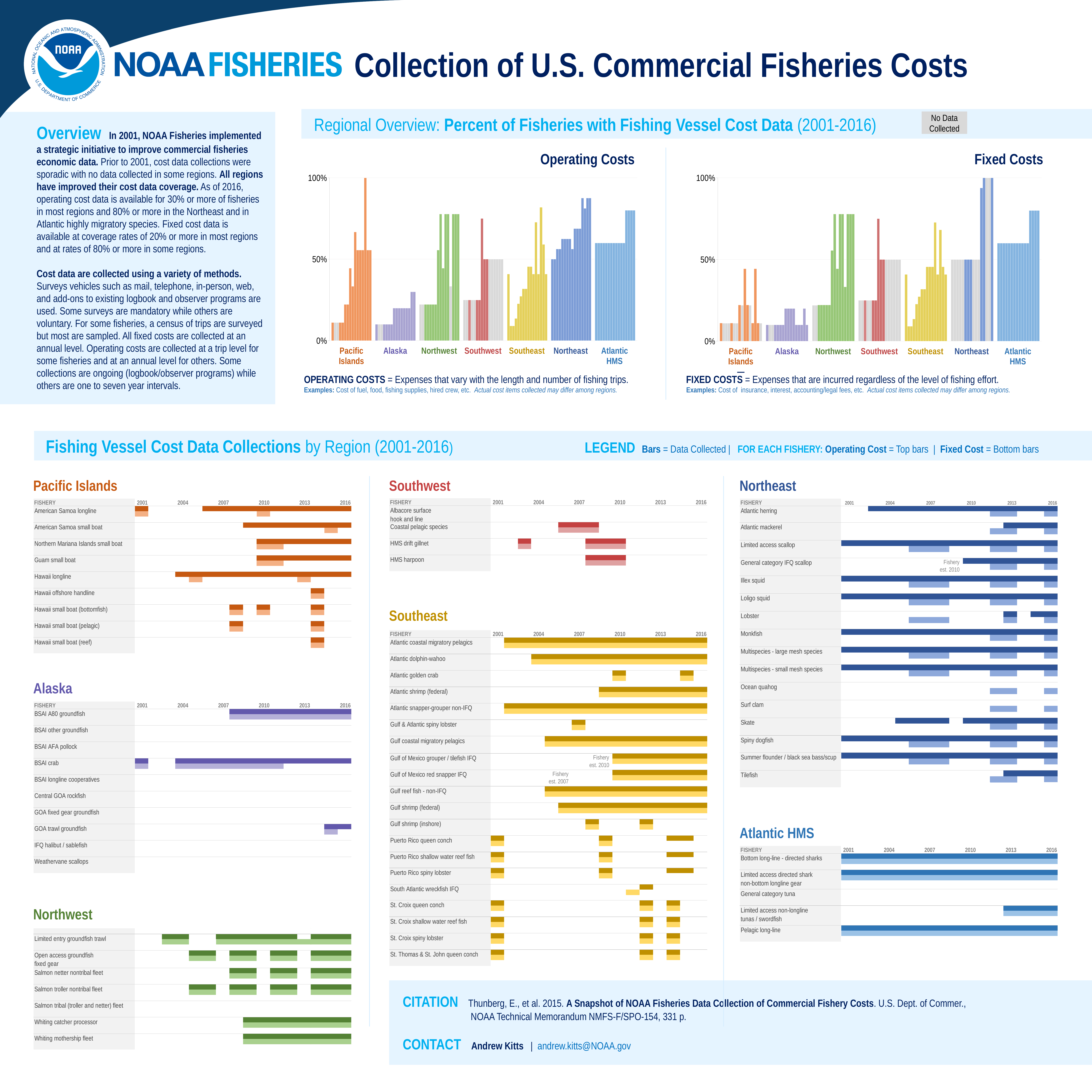
In the Fixed Costs chart, is the last bar for Atlantic HMS greater or less than 50%? greater How many fisheries are listed in the Southwest collections chart? 4 In the Operating Costs chart, is the tallest bar for Northwest greater or less than 50%? greater In the Operating Costs chart, is the tallest bar for Alaska greater or less than 50%? less What kind of chart is the Operating Costs chart in the Regional Overview? Bar chart How many fisheries are listed in the Pacific Islands collections chart? 9 What is the highest value shown on the y axis of the Fixed Costs chart? 100% How many regions are shown along the x axis of the Operating Costs chart? 7 What do the grey bars in the Regional Overview charts indicate? No Data Collected